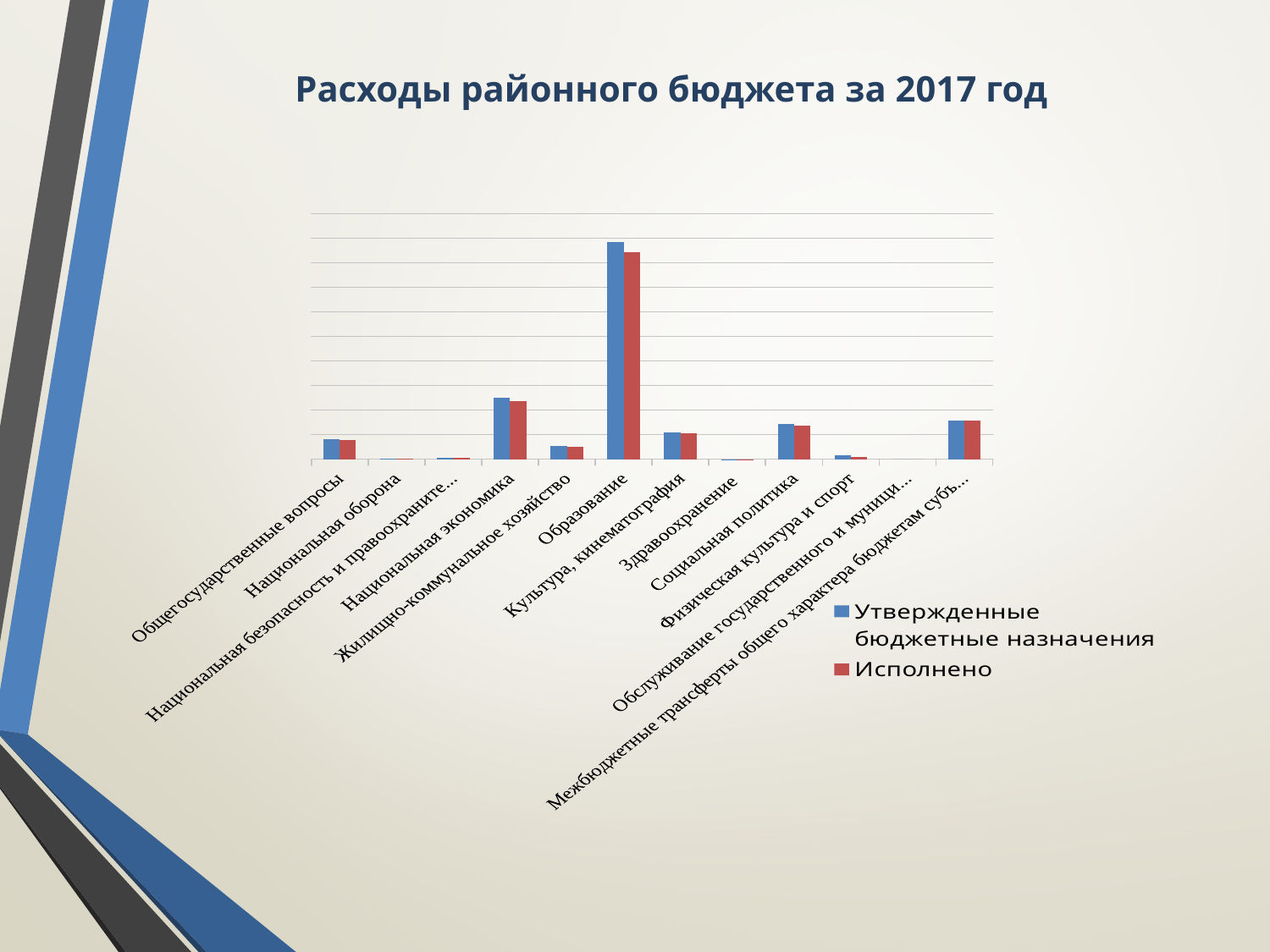
How many series does the legend list? 2 Which category has the second-highest bars after Образование? Национальная экономика How many categories are shown on the x axis? 12 Which is larger for Утвержденные бюджетные назначения: Общегосударственные вопросы or Жилищно-коммунальное хозяйство? Общегосударственные вопросы Which category has the highest value for Утвержденные бюджетные назначения? Образование For Образование, which series has the taller bar: Утвержденные бюджетные назначения or Исполнено? Утвержденные бюджетные назначения What are the two series named in the legend? Утвержденные бюджетные назначения; Исполнено What kind of chart is shown on the slide? bar chart Which is larger for Утвержденные бюджетные назначения: Образование or Национальная экономика? Образование Which category has the highest value for Исполнено? Образование What is the title of the chart? Расходы районного бюджета за 2017 год